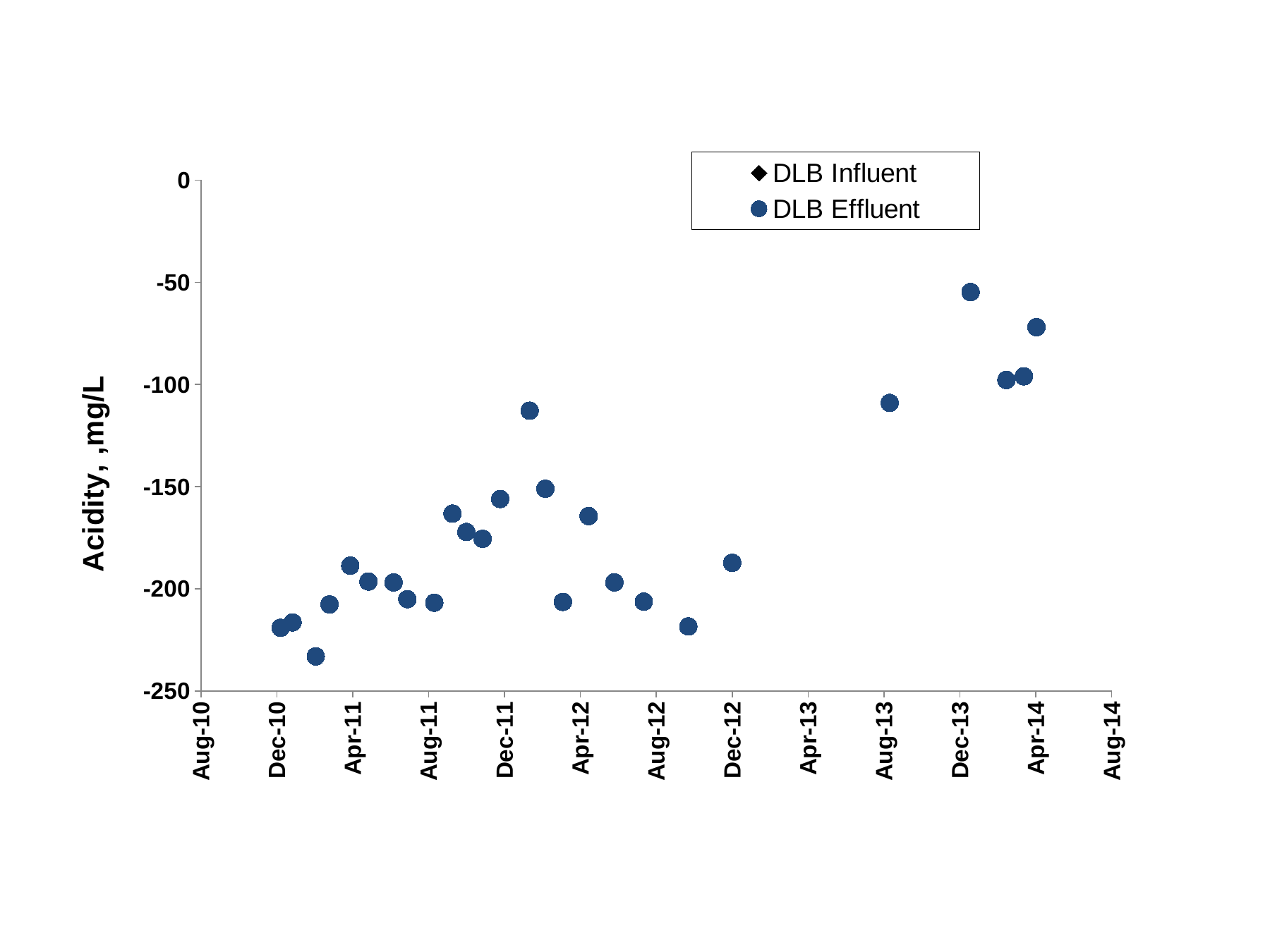
Do the DLB Effluent values generally rise or fall from Dec-10 to Apr-14? rise Which is higher: the DLB Effluent value near Aug-13 or the value at Dec-12? Aug-13 What are the two series named in the legend? DLB Influent and DLB Effluent Which series has points visibly plotted on the chart? DLB Effluent Is the lowest DLB Effluent value (in early 2011) greater or less than -200? less Is the DLB Effluent value plotted near Aug-13 greater or less than -150? greater How many series does the legend list? 2 Is the highest DLB Effluent value (near Dec-13) greater or less than -100? greater What kind of chart is shown on the slide? scatter chart What is the label on the vertical axis? Acidity, ,mg/L Which is higher: the DLB Effluent value near Dec-13 or the value near Apr-14? Dec-13